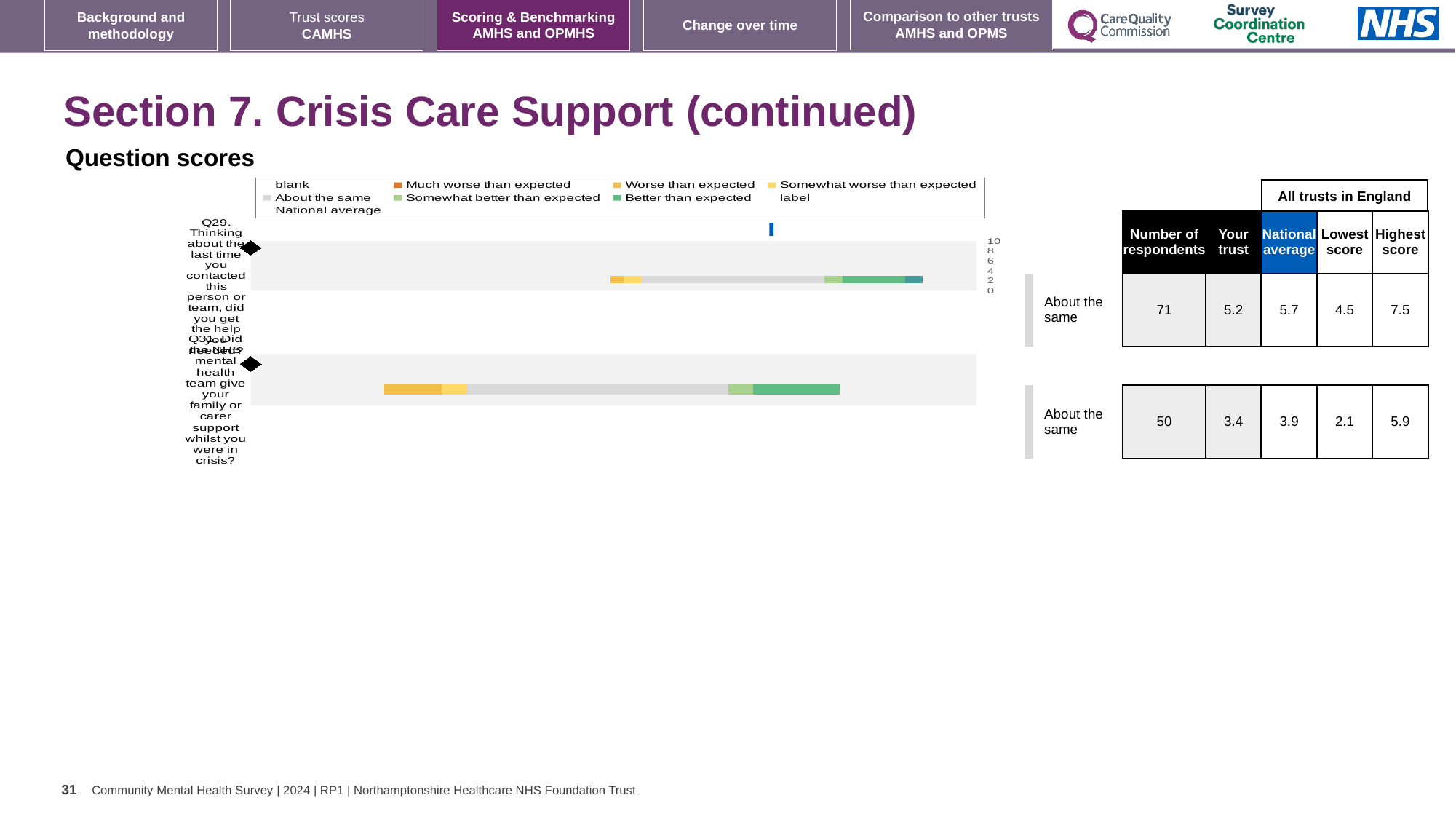
How many questions (bars) are plotted in the chart? 2 What kind of chart is shown under 'Question scores'? bar chart What is the difference between the highest score and the lowest score for Q29? 3.0 How many entries does the chart legend list? 9 Which legend entry is shown with an orange marker? Much worse than expected What is the number of respondents for Q29? 71 For Q29, which is larger: the 'Your trust' score or the national average? National average What is the 'Your trust' score for Q31? 3.4 What benchmark category is given for Q31? About the same What is the national average for Q29? 5.7 Which question has more respondents, Q29 or Q31? Q29 What is the highest score across all trusts in England for Q31? 5.9